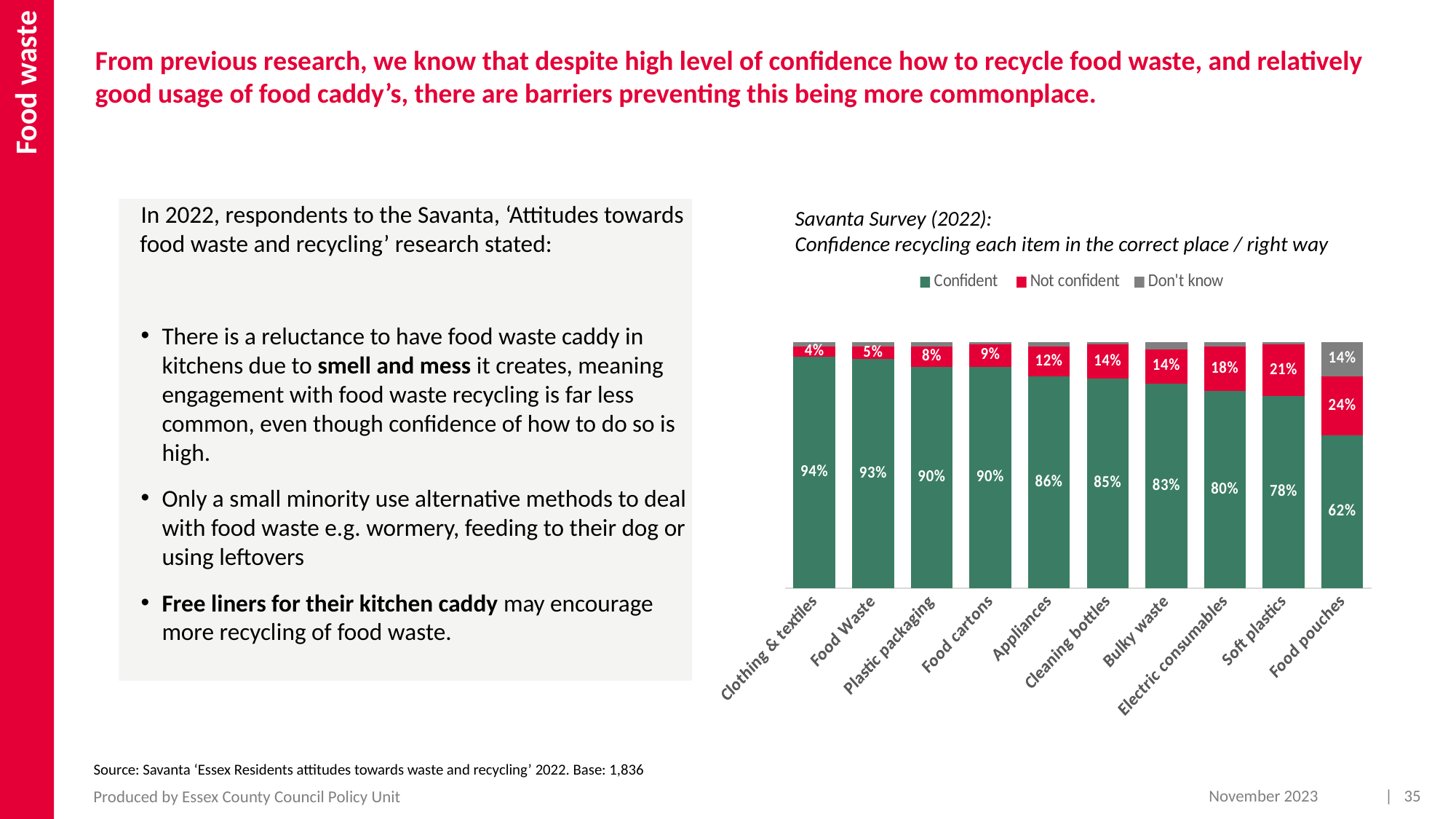
Which item has the highest 'Confident' percentage? Clothing & textiles Which item has the lowest 'Confident' percentage? Food pouches How many items are shown on the x axis of the chart? 10 What is the 'Not confident' value for Soft plastics? 21% How many series does the chart legend list? 3 Do the 'Confident' values rise or fall moving from left to right along the x axis? Fall What percentage of respondents are confident recycling Food Waste in the correct place? 93% What is the 'Don't know' value for Food pouches? 14% Which series in the chart is shown in red? Not confident Which has a larger 'Not confident' value, Appliances or Electric consumables? Electric consumables What is the difference between the 'Confident' values for Clothing & textiles and Food pouches? 32 percentage points What kind of chart is shown on the slide? Stacked bar chart